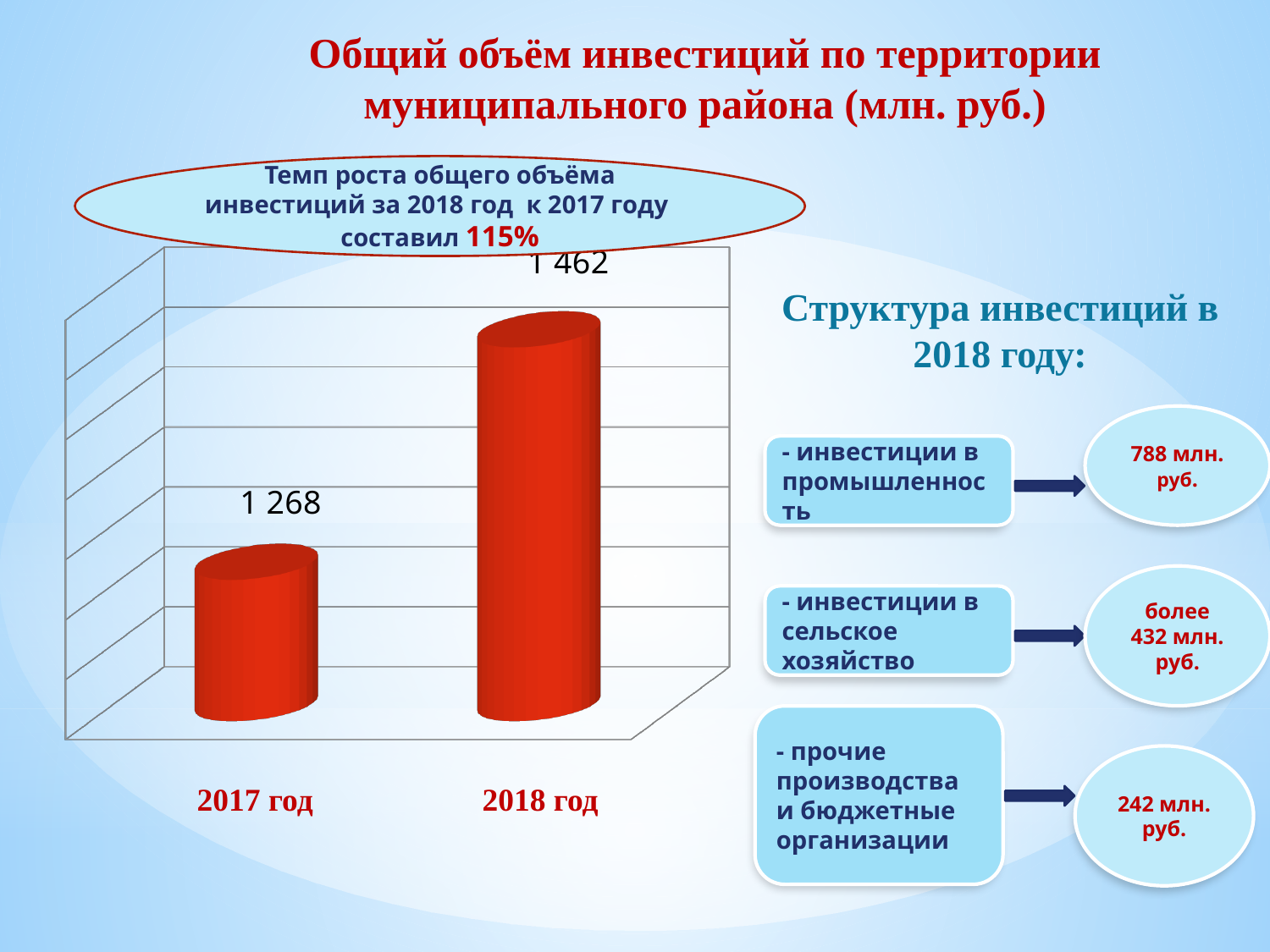
Which is larger, the value for 2017 год or for 2018 год? 2018 год Do the values rise or fall from 2017 год to 2018 год? rise What is the value for 2017 год? 1 268 How many categories are shown in the chart? 2 What is the value for 2018 год? 1 462 What kind of chart is shown on the slide? bar chart What is the title of the chart on the slide? Общий объём инвестиций по территории муниципального района (млн. руб.) What is the difference between the values for 2018 год and 2017 год? 194 Which year has the highest value? 2018 год What colour are the bars in the chart? red Which year has the lowest value? 2017 год